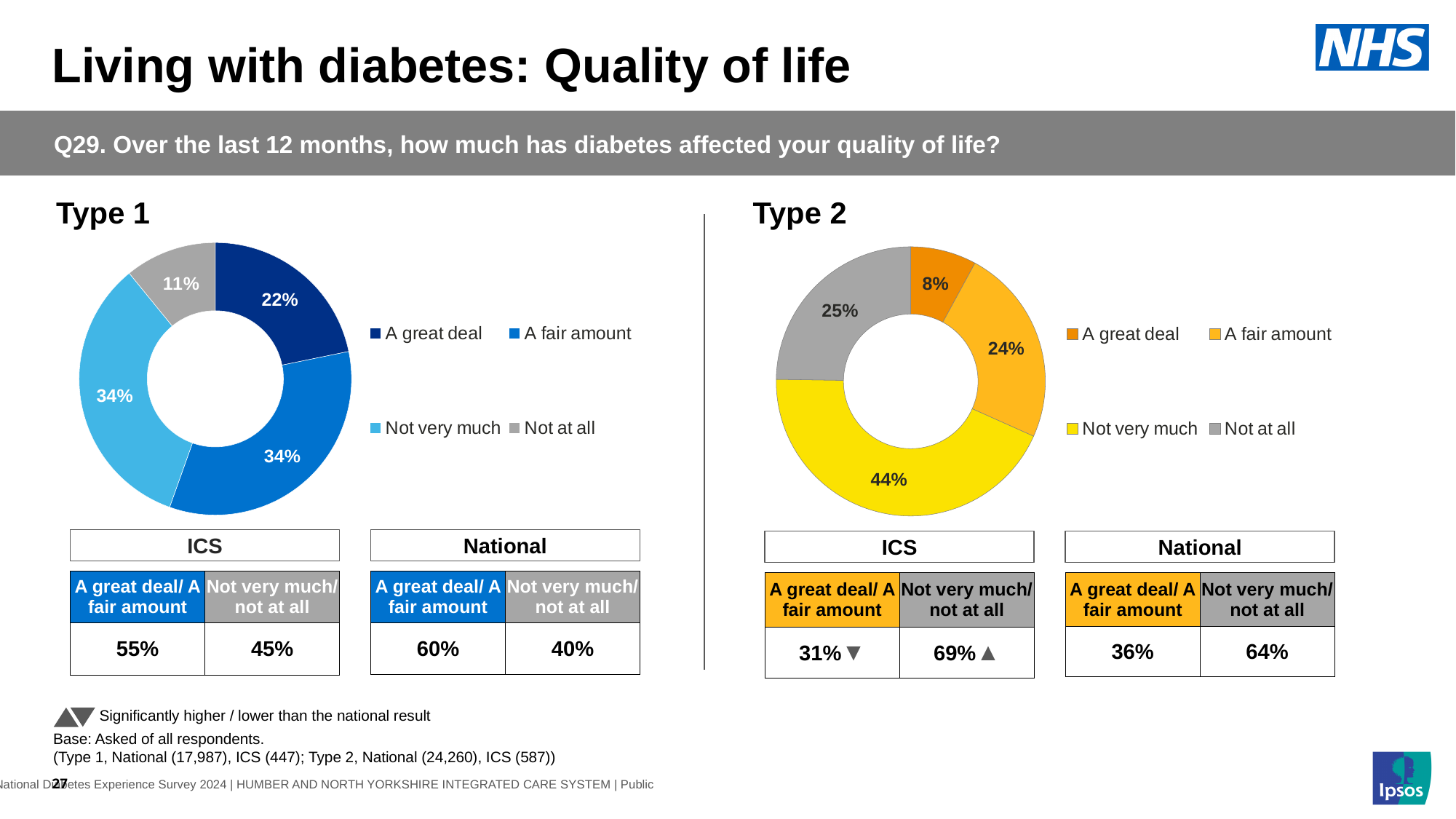
In the Type 2 chart, what is the difference between the 'Not very much' share and the 'Not at all' share? 19 percentage points In the Type 1 chart, what is the difference between the 'A fair amount' share and the 'A great deal' share? 12 percentage points In the Type 2 chart, which category has the smallest share? A great deal In the Type 1 chart, which category has the smallest share? Not at all In the Type 2 chart, which category has the largest share? Not very much In the Type 2 chart, what percentage is shown for 'Not very much'? 44% How many categories does the legend of the Type 2 chart list? 4 In the Type 2 chart, what percentage is shown for 'A fair amount'? 24% In the Type 1 chart, what percentage is shown for 'Not at all'? 11% Which is larger: the 'A great deal' share in the Type 1 chart or the 'A great deal' share in the Type 2 chart? Type 1 What kind of chart is used for Type 1? Donut (pie) chart In the Type 1 chart, what percentage of respondents said diabetes affected their quality of life 'A great deal'? 22%